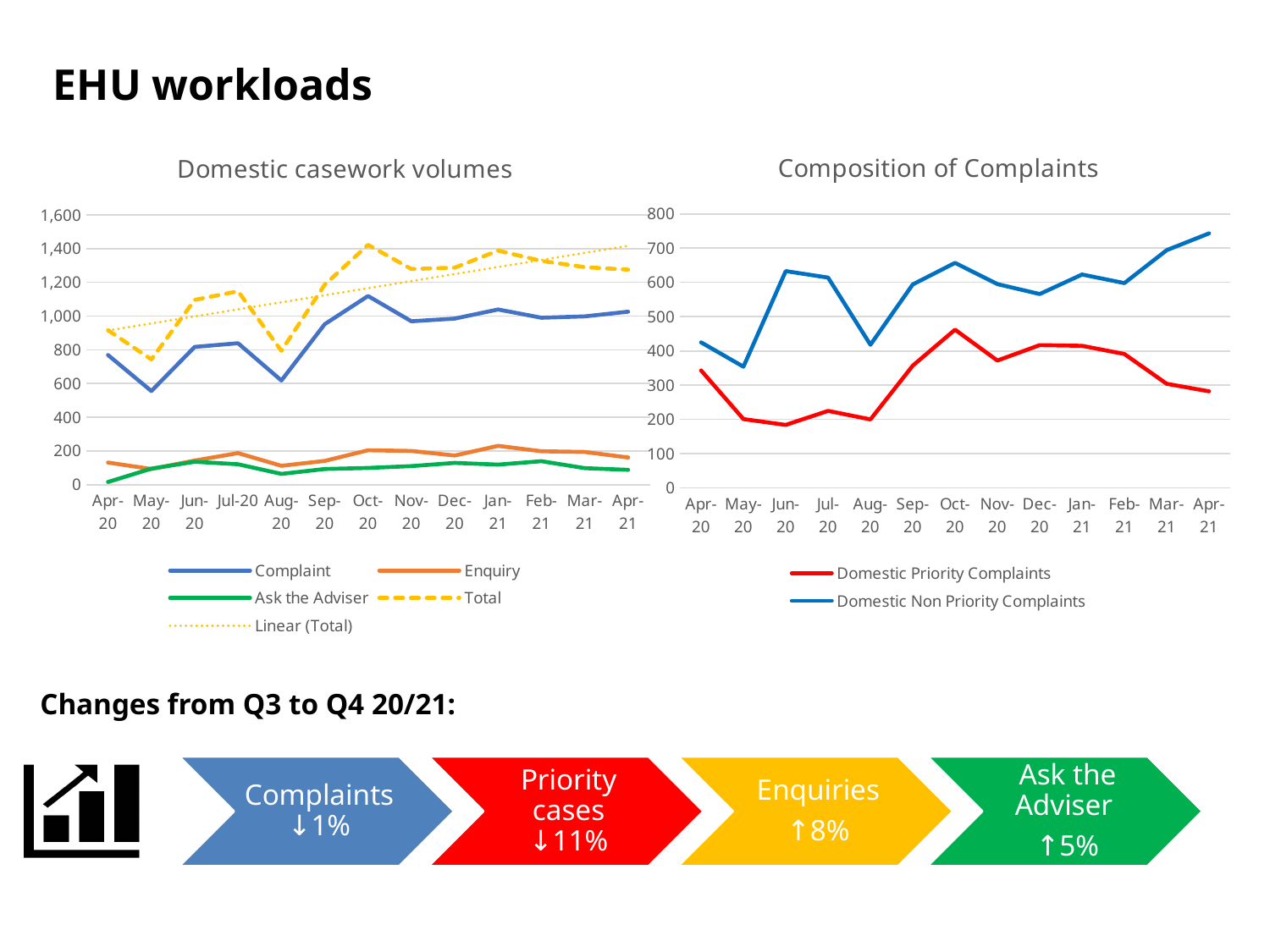
In the "Domestic casework volumes" chart, is the Complaint value for May-20 greater or less than 600? less How many series does the legend of the "Composition of Complaints" chart list? 2 In the "Composition of Complaints" chart, in which month is Domestic Non Priority Complaints highest? Apr-21 In the "Domestic casework volumes" chart, is the Total value for Oct-20 greater or less than 1,200? greater In the "Domestic casework volumes" chart, which series is shown as a dashed yellow line? Total In the "Composition of Complaints" chart, is the Domestic Priority Complaints value for Oct-20 greater or less than 400? greater How many months are plotted along the x axis of the "Composition of Complaints" chart? 13 What kind of chart is the "Domestic casework volumes" chart? line chart In the "Composition of Complaints" chart, which series is larger in Apr-21, Domestic Priority Complaints or Domestic Non Priority Complaints? Domestic Non Priority Complaints How many series does the legend of the "Domestic casework volumes" chart list? 5 In the "Domestic casework volumes" chart, in which month is the Complaint series lowest? May-20